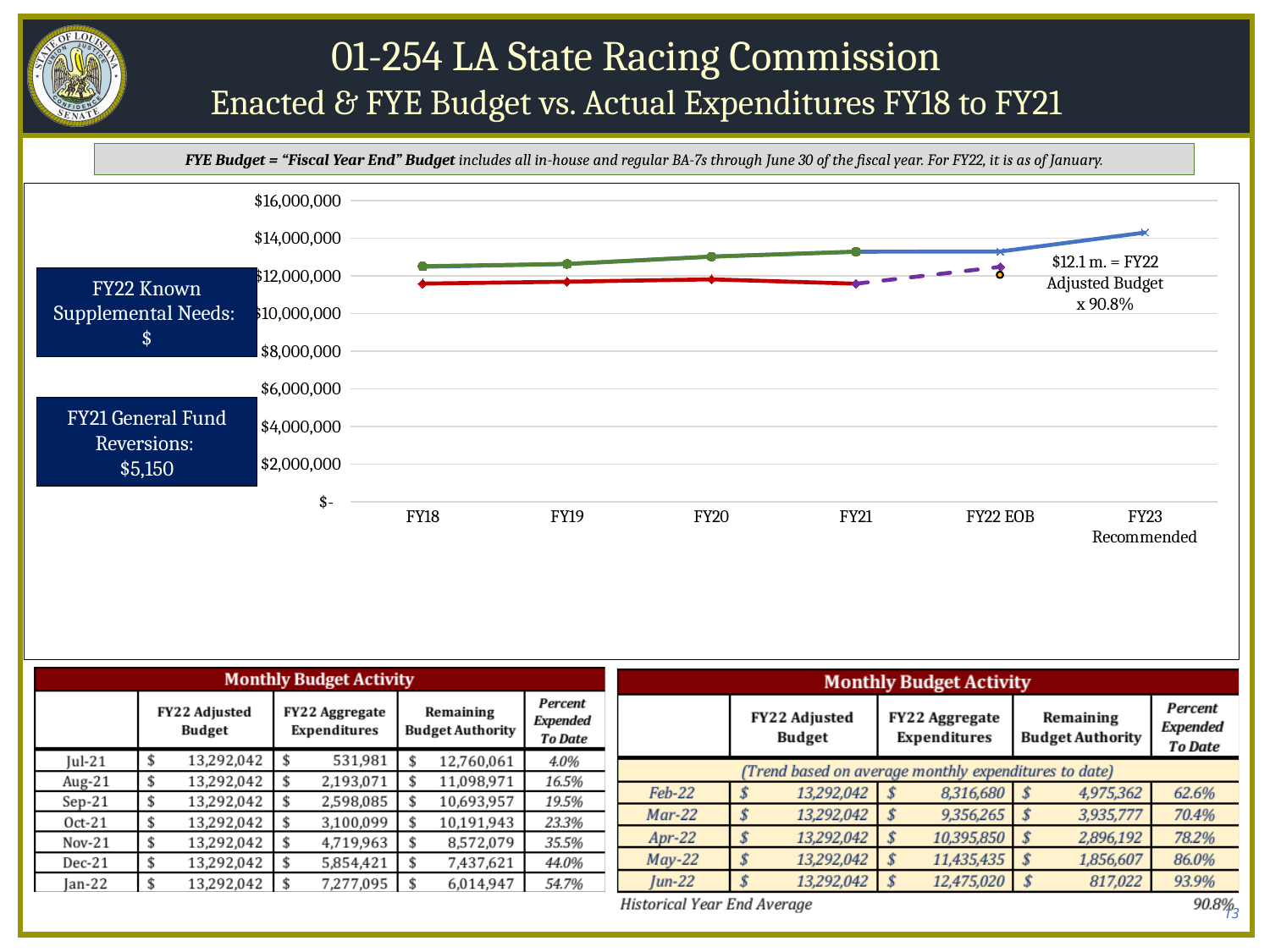
Does the blue line rise or fall from FY22 EOB to FY23 Recommended? rise Does the green line rise or fall from FY18 to FY21? rise Is the value of the red line at FY18 greater or less than $12,000,000? less What is the highest value labelled on the y axis of the chart? $16,000,000 How many fiscal-year categories are shown on the x axis of the chart? 6 At FY18, which line has the higher value, the green line or the red line? green line What is the last category on the x axis of the chart? FY23 Recommended Is the value of the green line at FY21 greater or less than $12,000,000? greater What kind of chart is shown on the slide? line chart Is the value of the green line at FY18 greater or less than $12,000,000? greater